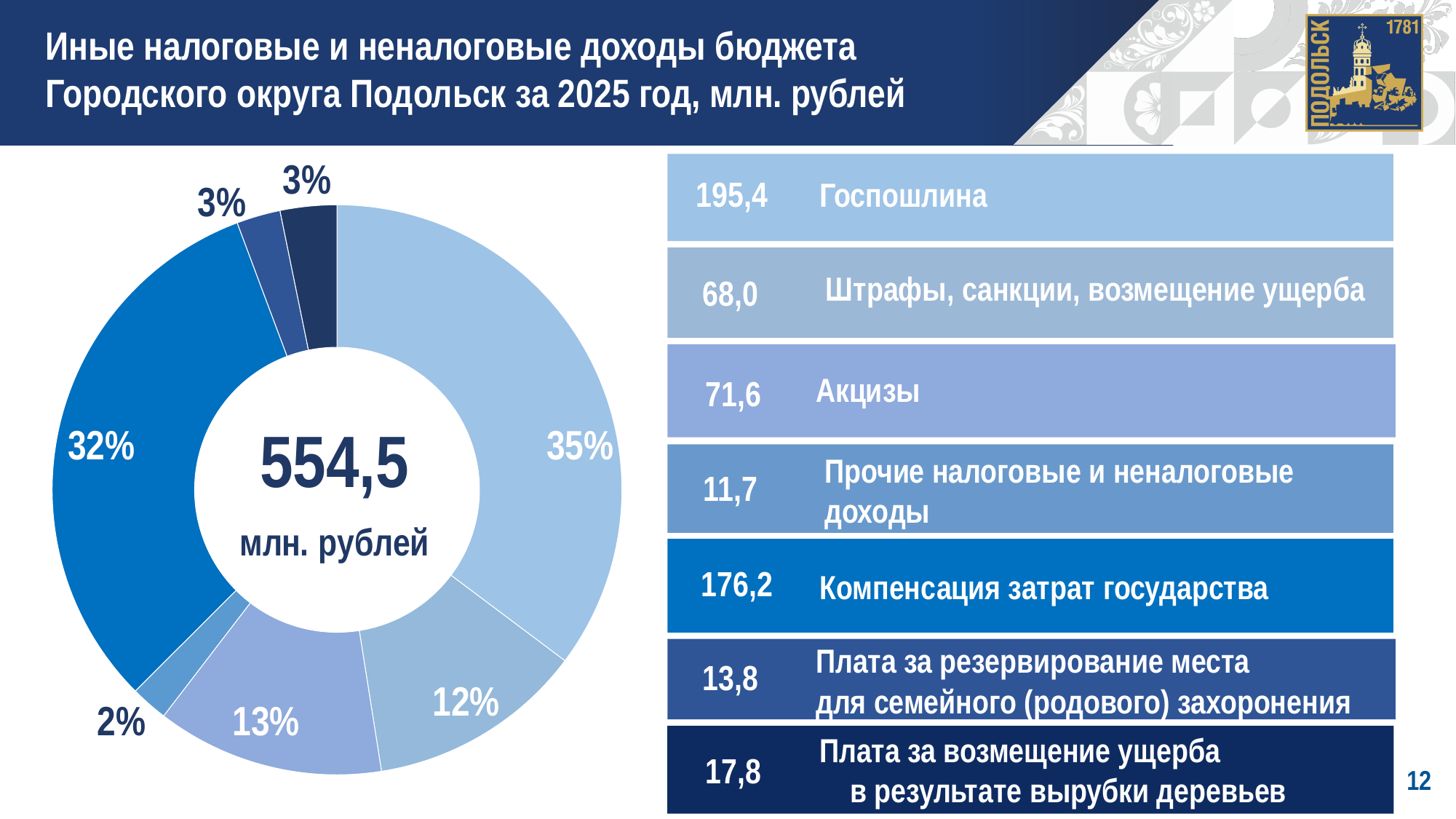
Which is larger: Штрафы, санкции, возмещение ущерба or Акцизы? Акцизы What is the difference between the values for Госпошлина and Компенсация затрат государства? 19,2 What is the value for Плата за возмещение ущерба в результате вырубки деревьев? 17,8 How many categories does the legend list? 7 What is the value for Компенсация затрат государства? 176,2 What kind of chart is shown on the slide? pie chart (donut) What total value is shown in the centre of the donut chart? 554,5 млн. рублей What is the value for Акцизы? 71,6 What share of the donut chart does the largest slice (Госпошлина) take? 35% Which category has the highest value? Госпошлина What is the value for Госпошлина? 195,4 Which category has the lowest value? Прочие налоговые и неналоговые доходы